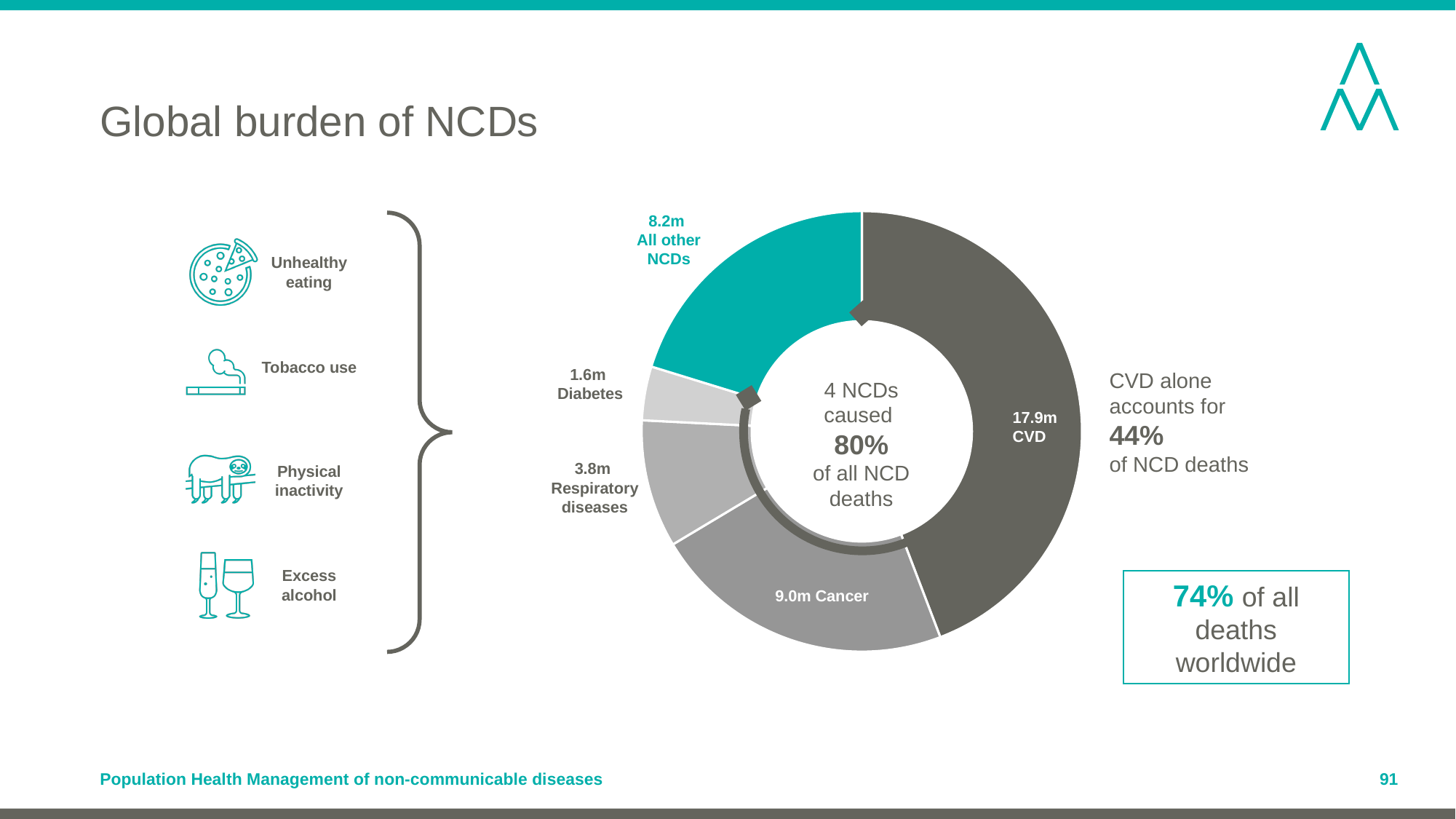
According to the slide, what share of NCD deaths does CVD alone account for? 44% Which is larger, the Cancer slice or the All other NCDs slice? Cancer How many deaths are attributed to CVD in the chart? 17.9m What kind of chart is shown on the slide? Pie chart (donut) Which category has the smallest slice of the chart? Diabetes What value is shown for Diabetes? 1.6m How many slices does the chart have? 5 What value is shown for All other NCDs? 8.2m What is the difference between the CVD and Cancer values? 8.9m Which category has the largest slice of the chart? CVD How many deaths are attributed to Cancer in the chart? 9.0m What value is shown for Respiratory diseases? 3.8m